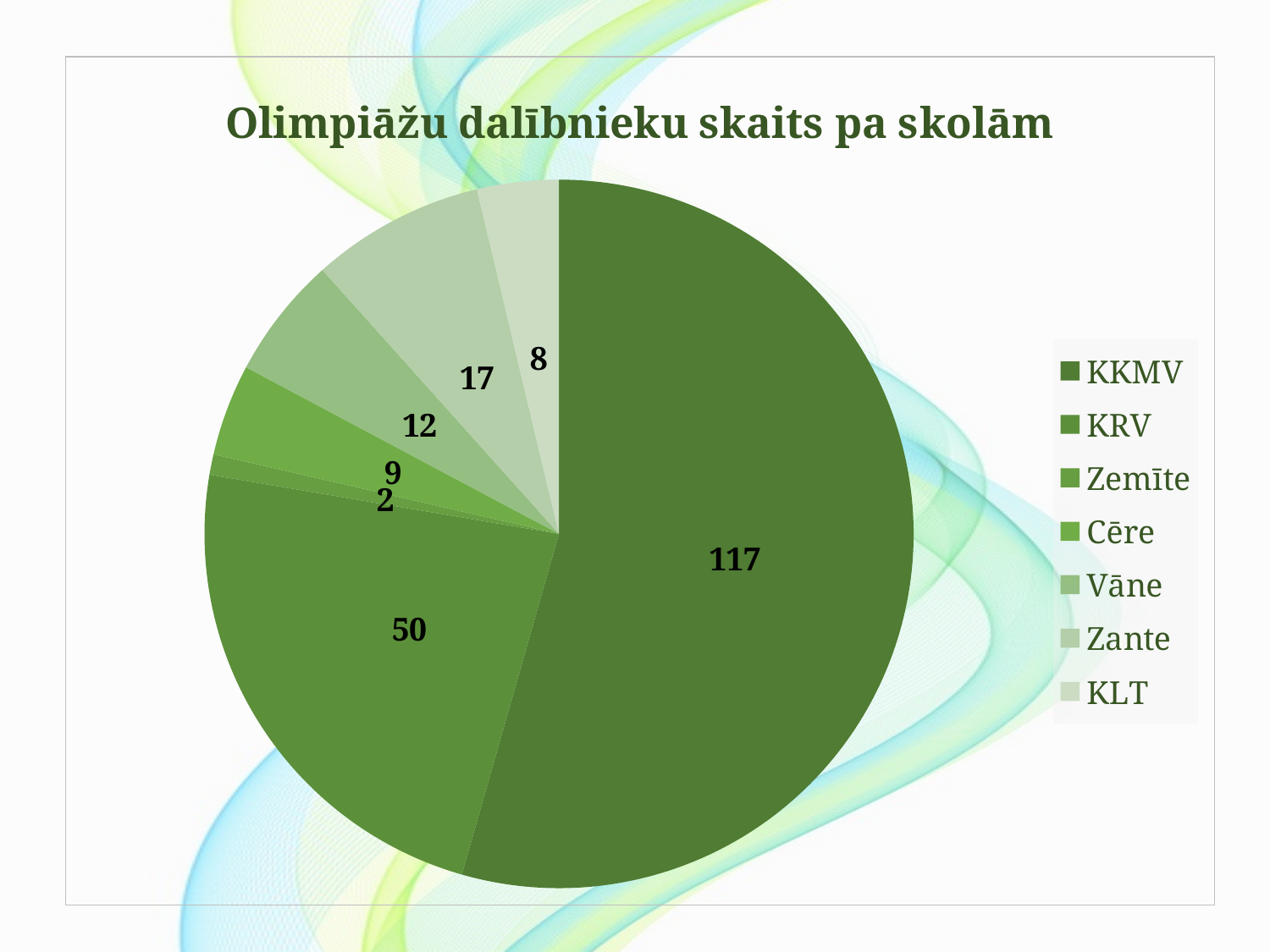
What is the difference between the values for KKMV and KRV? 67 What is the value for KRV? 50 What is the title of the chart? Olimpiāžu dalībnieku skaits pa skolām What is the value for Vāne? 12 What is the value for Zante? 17 What kind of chart is shown on the slide? pie chart What is the value for KKMV? 117 Which school has the smallest slice? Zemīte What is the total of all slices in the pie? 215 Which school has the largest slice? KKMV How many schools does the legend list? 7 Which is larger, the value for Cēre or the value for KLT? Cēre